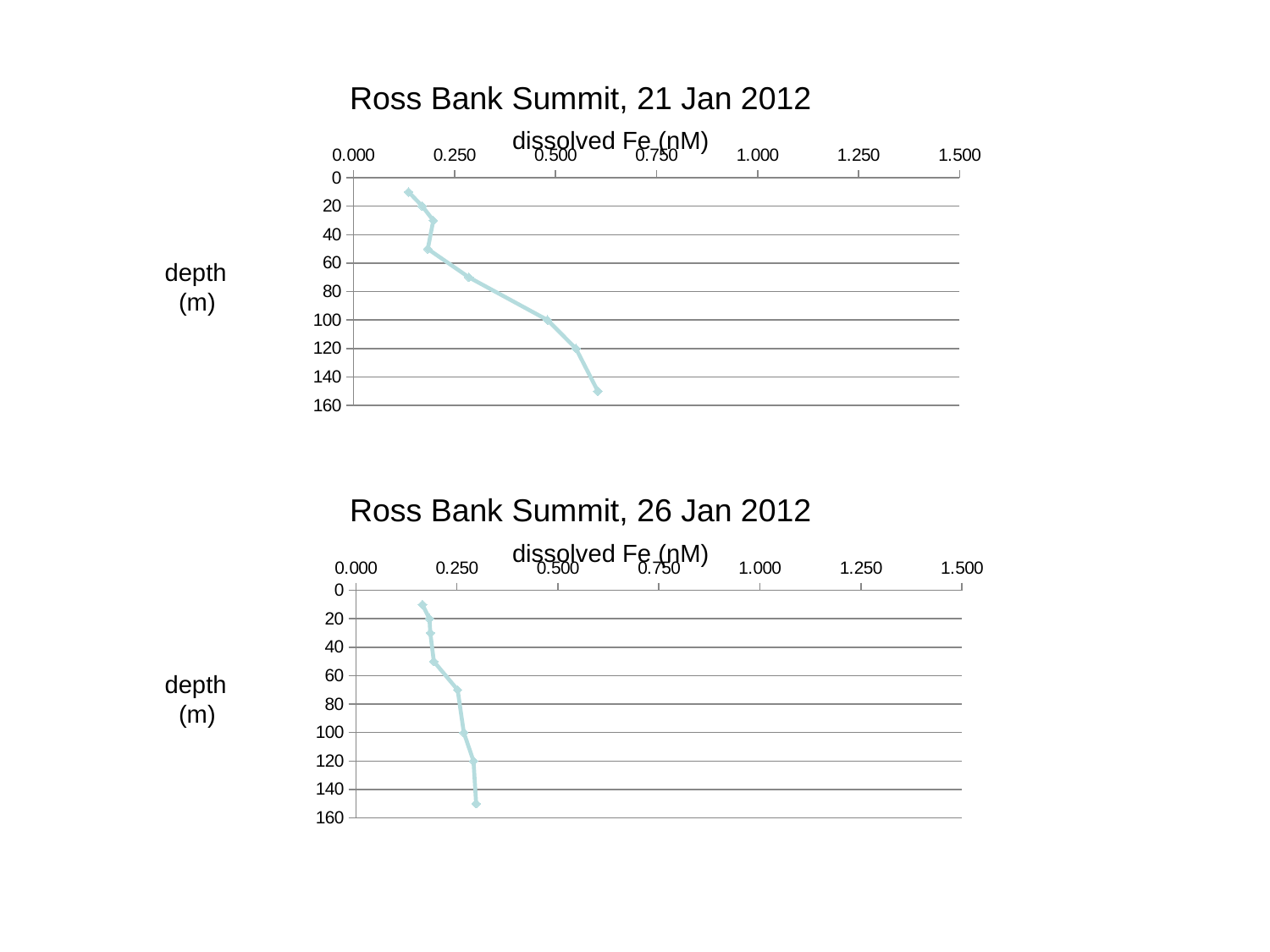
In the 'Ross Bank Summit, 21 Jan 2012' chart, does dissolved Fe generally increase or decrease as depth increases? increase What is the x-axis title of the 'Ross Bank Summit, 26 Jan 2012' chart? dissolved Fe (nM) Which chart shows the larger dissolved Fe value at 150 m depth, the 21 Jan 2012 chart or the 26 Jan 2012 chart? 21 Jan 2012 In the 'Ross Bank Summit, 21 Jan 2012' chart, is the dissolved Fe value at 10 m depth greater or less than 0.250? less In the 'Ross Bank Summit, 21 Jan 2012' chart, how many data points are plotted? 8 In the 'Ross Bank Summit, 26 Jan 2012' chart, is the dissolved Fe value at 10 m depth greater or less than 0.250? less In the 'Ross Bank Summit, 21 Jan 2012' chart, is the dissolved Fe value at 150 m depth greater or less than 0.500? greater In the 'Ross Bank Summit, 26 Jan 2012' chart, at which depth is dissolved Fe lowest? 10 m What kind of chart is the 'Ross Bank Summit, 21 Jan 2012' chart? line chart In the 'Ross Bank Summit, 21 Jan 2012' chart, at which depth is dissolved Fe highest? 150 m What is the maximum value shown on the x axis of the 'Ross Bank Summit, 21 Jan 2012' chart? 1.500